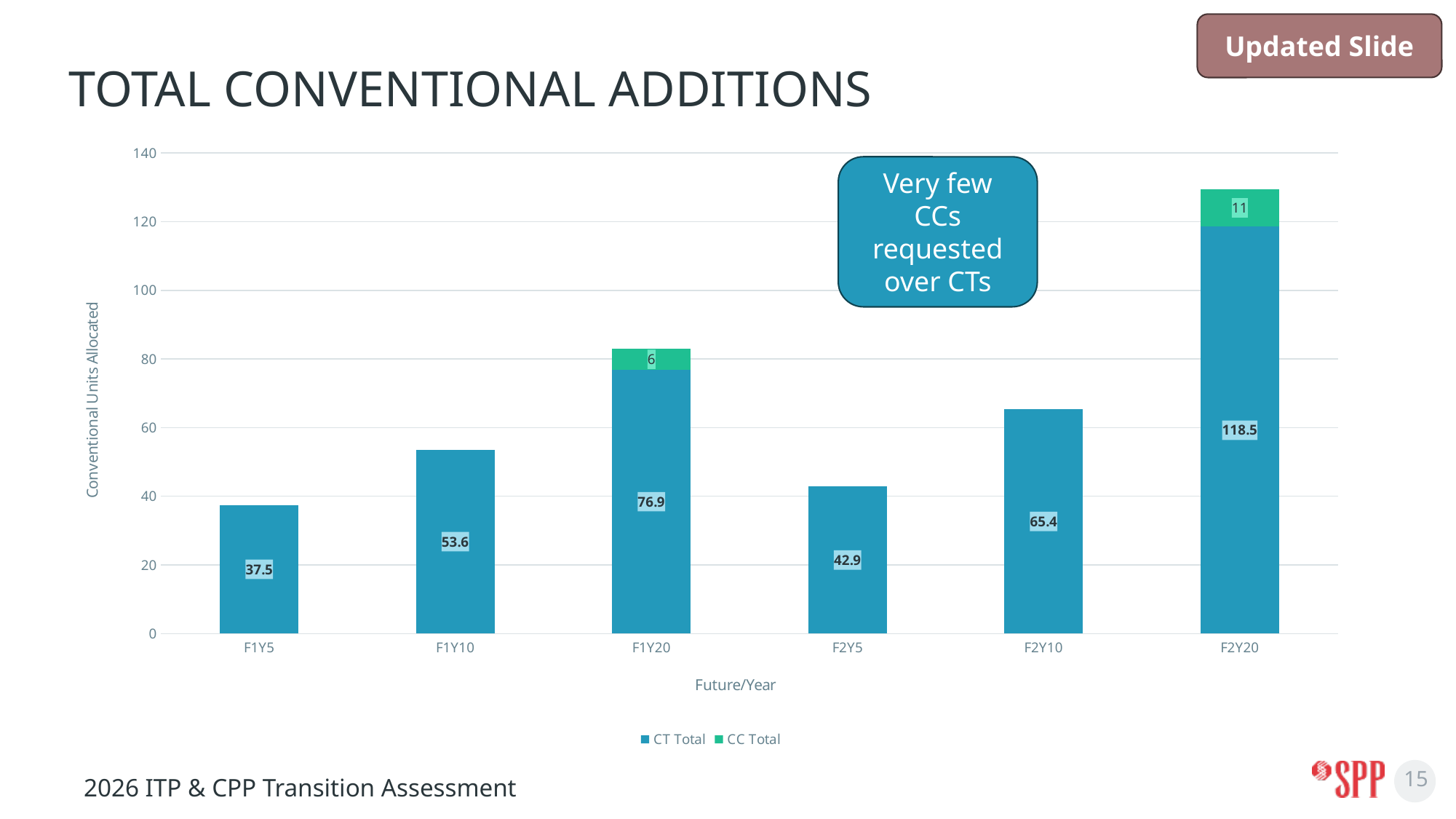
What is the CT Total value for F2Y10? 65.4 Which is larger, the CT Total for F1Y10 or the CT Total for F2Y5? F1Y10 What is the CC Total value for F1Y20? 6 What kind of chart is shown on the slide? Stacked bar chart How many series does the legend list? 2 Which Future/Year category has the lowest CT Total? F1Y5 Which Future/Year category has the highest CT Total? F2Y20 What is the difference between the CT Total for F2Y20 and the CT Total for F1Y20? 41.6 What is the CC Total value for F2Y20? 11 How many Future/Year categories are shown on the x axis? 6 What is the CT Total value for F1Y5? 37.5 What is the total height of the stacked bar for F2Y20 (CT Total plus CC Total)? 129.5